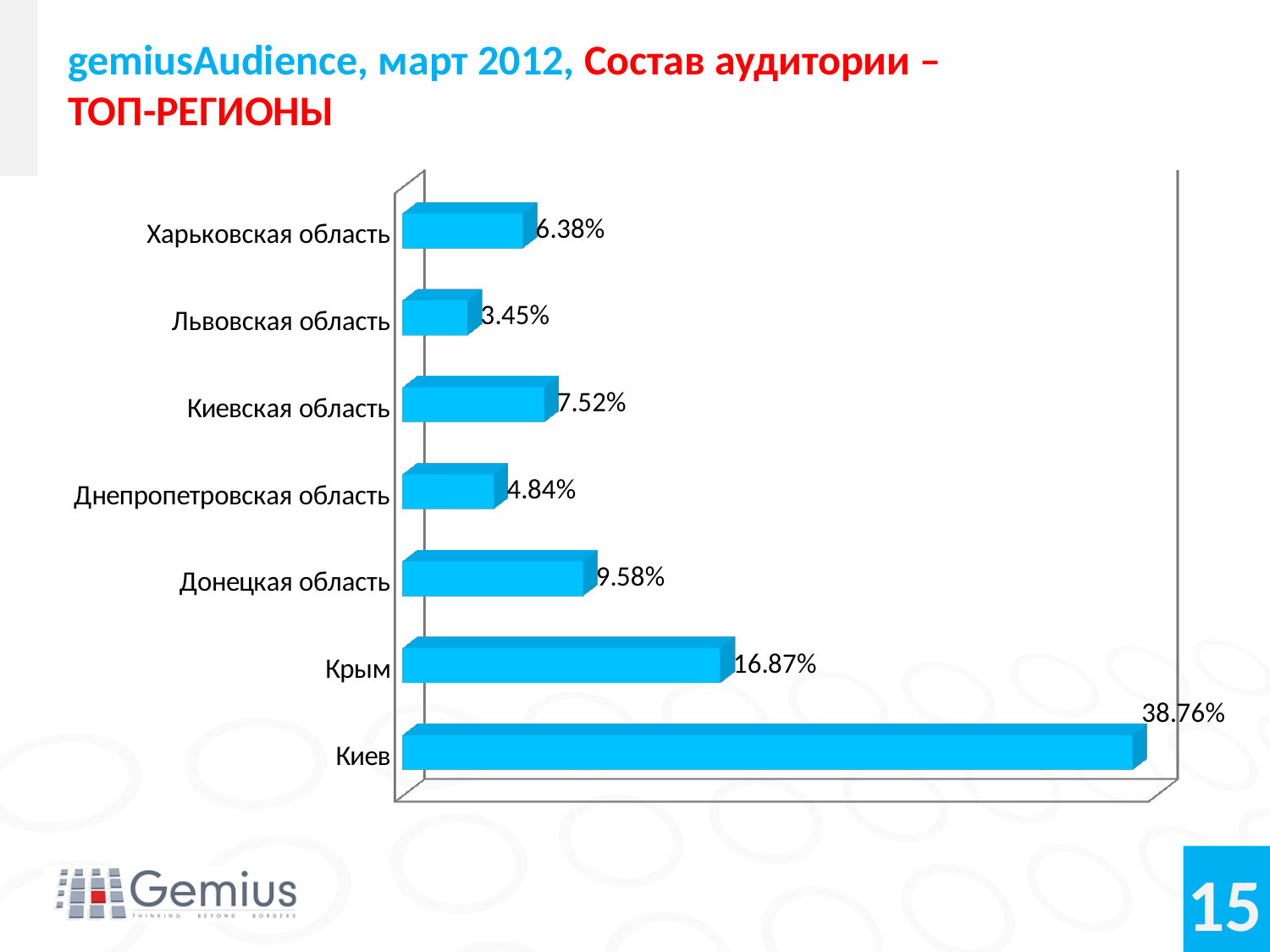
What is the value for Донецкая область? 9.58% What is the difference between the values for Киев and Крым? 21.89% What is the value for Крым? 16.87% What colour are the bars in the chart? Blue Which region has the lowest value? Львовская область Which is larger, the value for Днепропетровская область or the value for Харьковская область? Харьковская область What is the value for Львовская область? 3.45% What is the difference between the values for Киевская область and Харьковская область? 1.14% What kind of chart is shown on the slide? Bar chart What is the value for Киев? 38.76% How many regions are shown in the chart? 7 Which region has the highest value? Киев